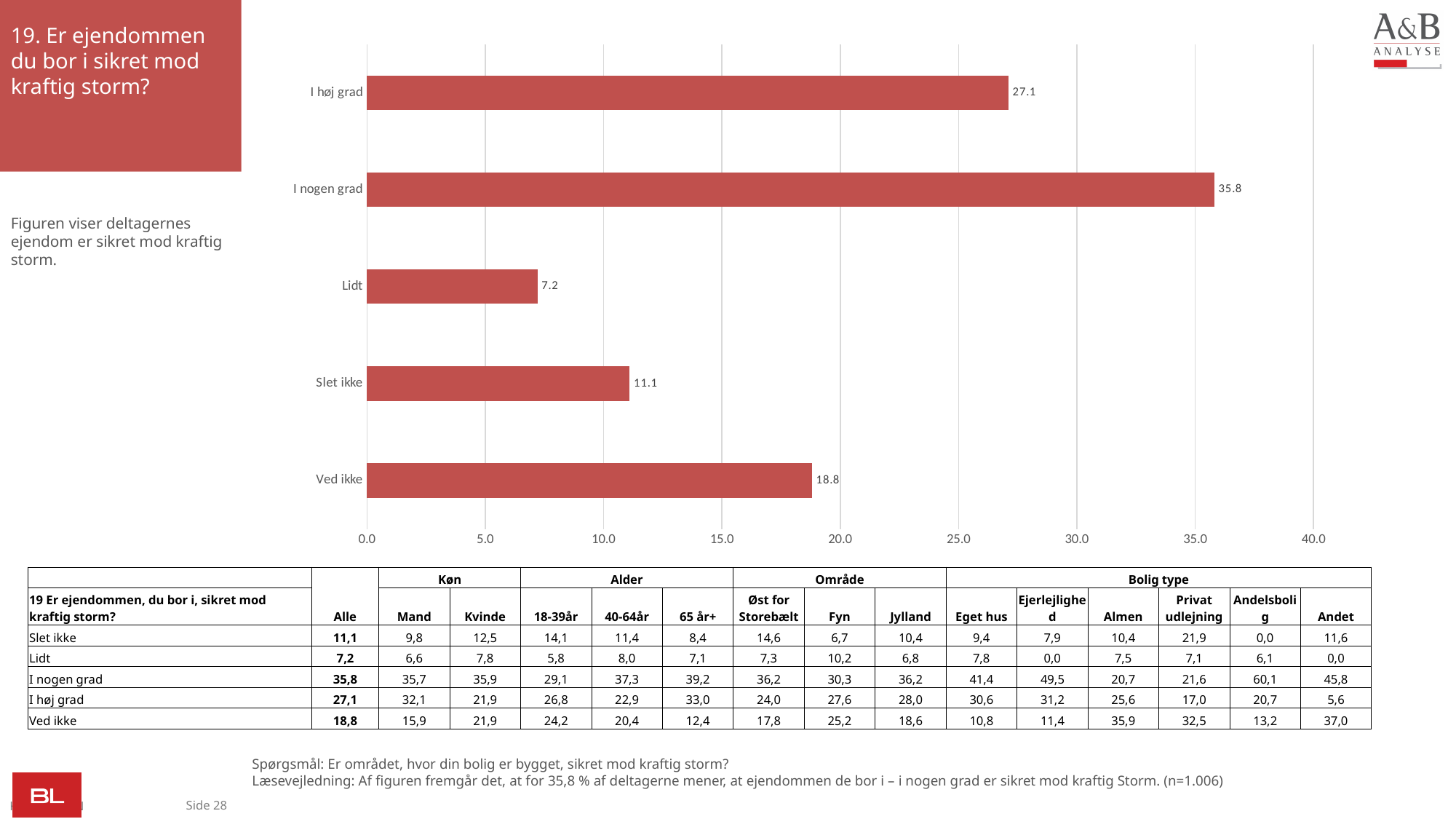
Which category has the lowest value? Lidt Is the value for "I høj grad" greater or less than 25.0? greater What is the difference between the values for "I nogen grad" and "I høj grad"? 8.7 What is the value for "Lidt"? 7.2 What is the maximum value shown on the horizontal axis? 40.0 Which is larger, the value for "Slet ikke" or the value for "Ved ikke"? Ved ikke Which category has the highest value? I nogen grad What is the value for "Ved ikke"? 18.8 What is the value for "I høj grad"? 27.1 What kind of chart is shown on the slide? bar chart What is the value for "I nogen grad"? 35.8 How many categories are shown in the bar chart? 5